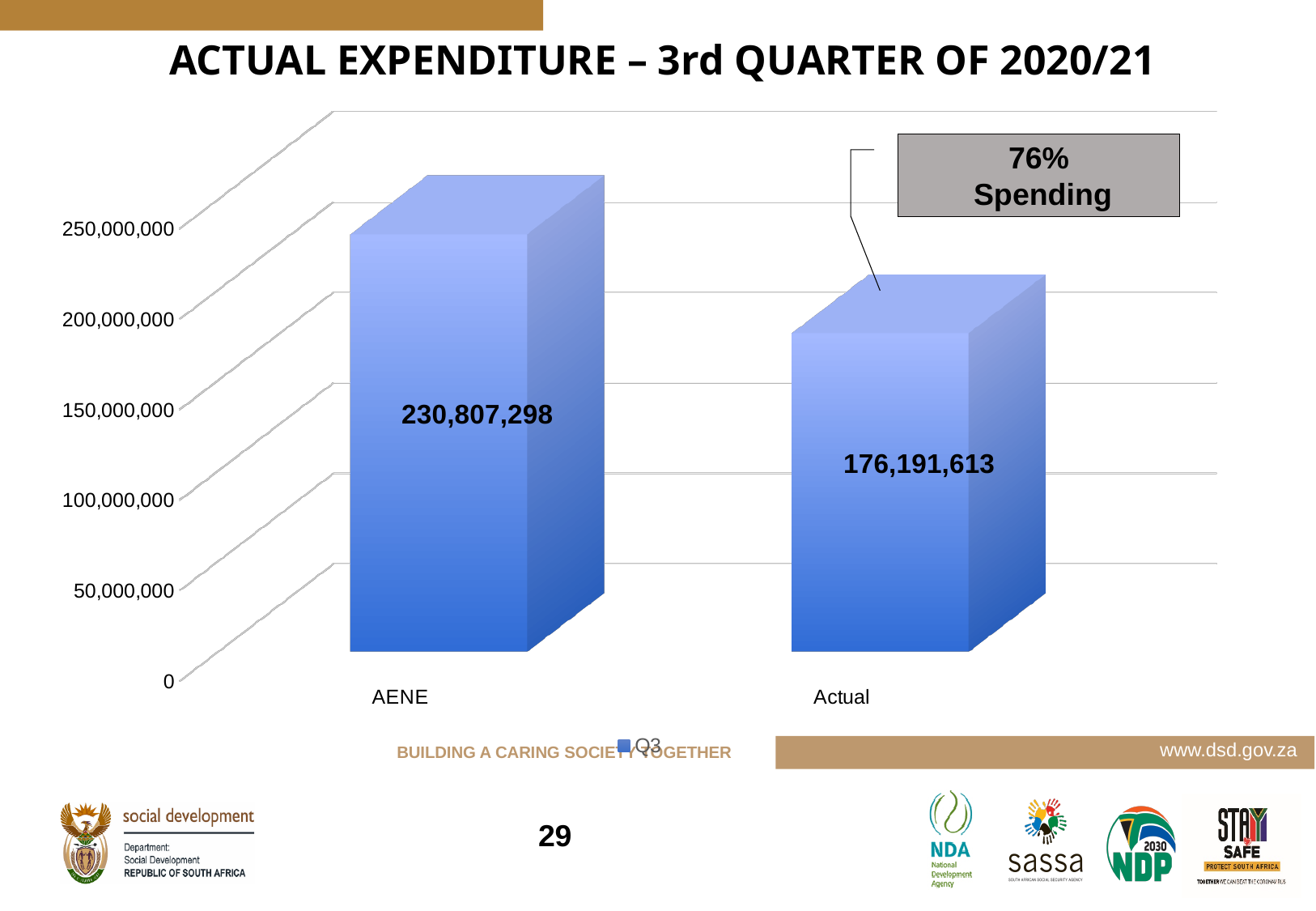
Is the value for AENE greater or less than 200,000,000? greater What is the value of the Actual bar? 176,191,613 What is the difference between the AENE value and the Actual value? 54,615,685 What kind of chart is shown on the slide? Bar chart What is the value of the AENE bar? 230,807,298 Is the value for Actual greater or less than 200,000,000? less How many categories are shown on the x axis? 2 What is the title of the chart? ACTUAL EXPENDITURE – 3rd QUARTER OF 2020/21 Which category has the higher value, AENE or Actual? AENE What spending percentage is shown in the annotation box above the Actual bar? 76% How many series does the legend list? 1 Which category has the lowest value? Actual